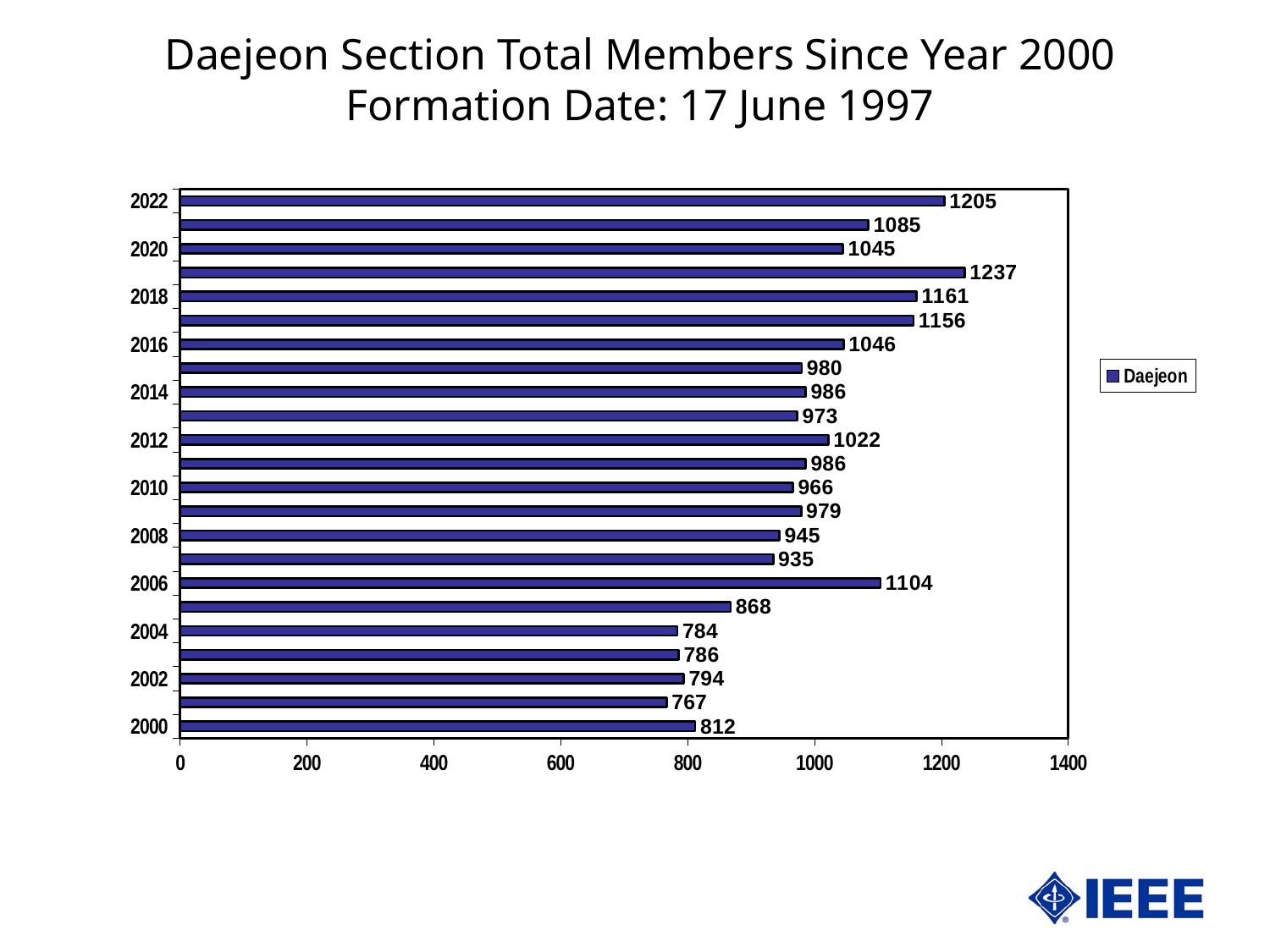
What is the highest value shown on the chart? 1237 What is the value for 2000? 812 How many series does the legend list? 1 What is the value for 2018? 1161 How many bars are shown on the chart? 23 What is the lowest value shown on the chart? 767 What is the value for 2022? 1205 Is the value for 2012 greater or less than 1000? greater What kind of chart is shown? bar chart What is the value for 2006? 1104 What is the difference between the values for 2022 and 2000? 393 Which year has the larger value, 2018 or 2016? 2018